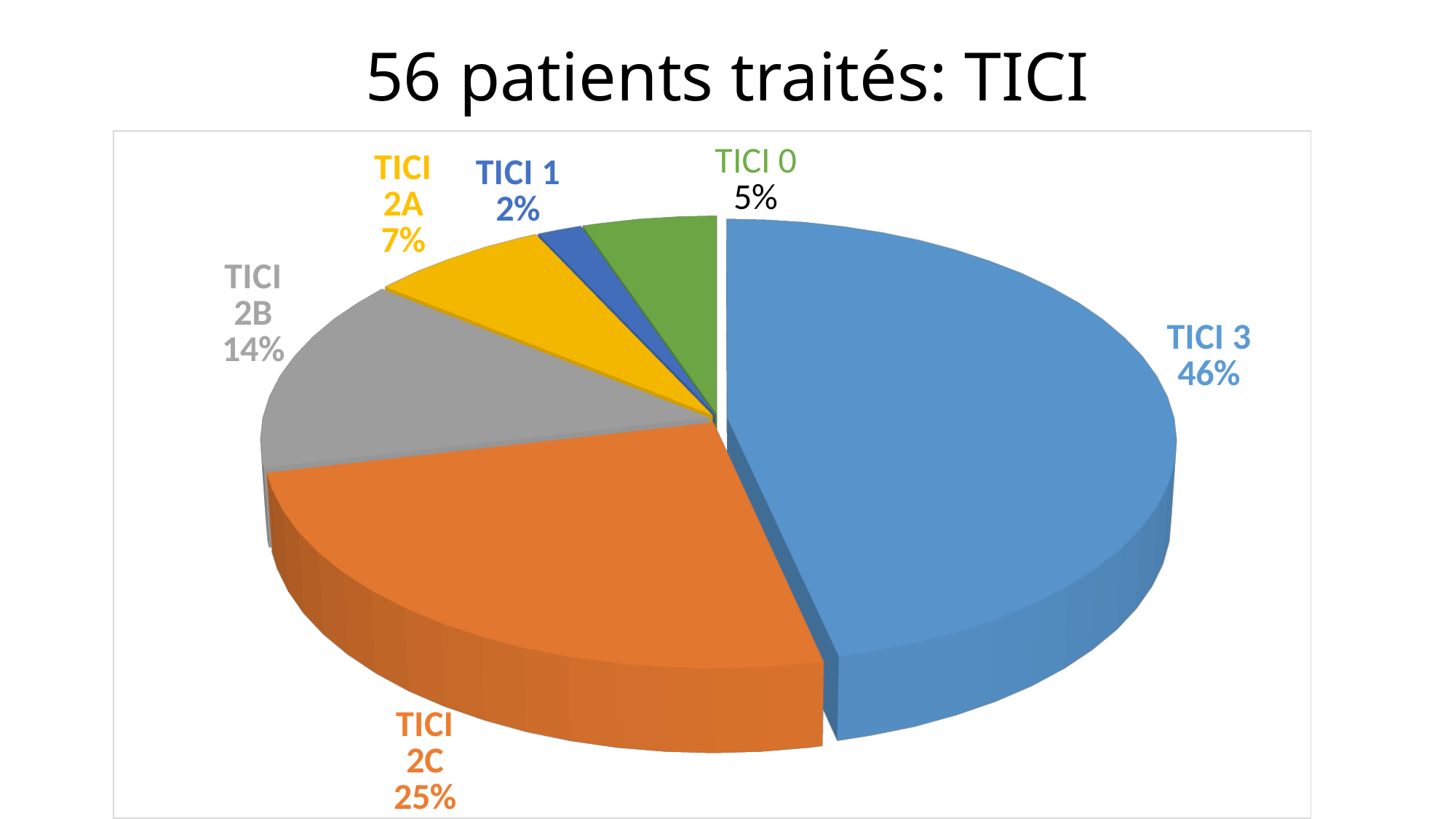
Which is larger, the share for TICI 2B or the share for TICI 2A? TICI 2B What percentage of patients had TICI 0? 5% How many categories are shown in the pie chart? 6 What type of chart is shown on the slide? pie chart What percentage of patients had TICI 3? 46% What percentage of patients had TICI 2A? 7% What percentage of patients had TICI 2B? 14% What percentage of patients had TICI 2C? 25% Which TICI category has the largest share of the pie? TICI 3 What is the title of the chart? 56 patients traités: TICI Which TICI category has the smallest share of the pie? TICI 1 What is the difference in percentage points between TICI 3 and TICI 2C? 21